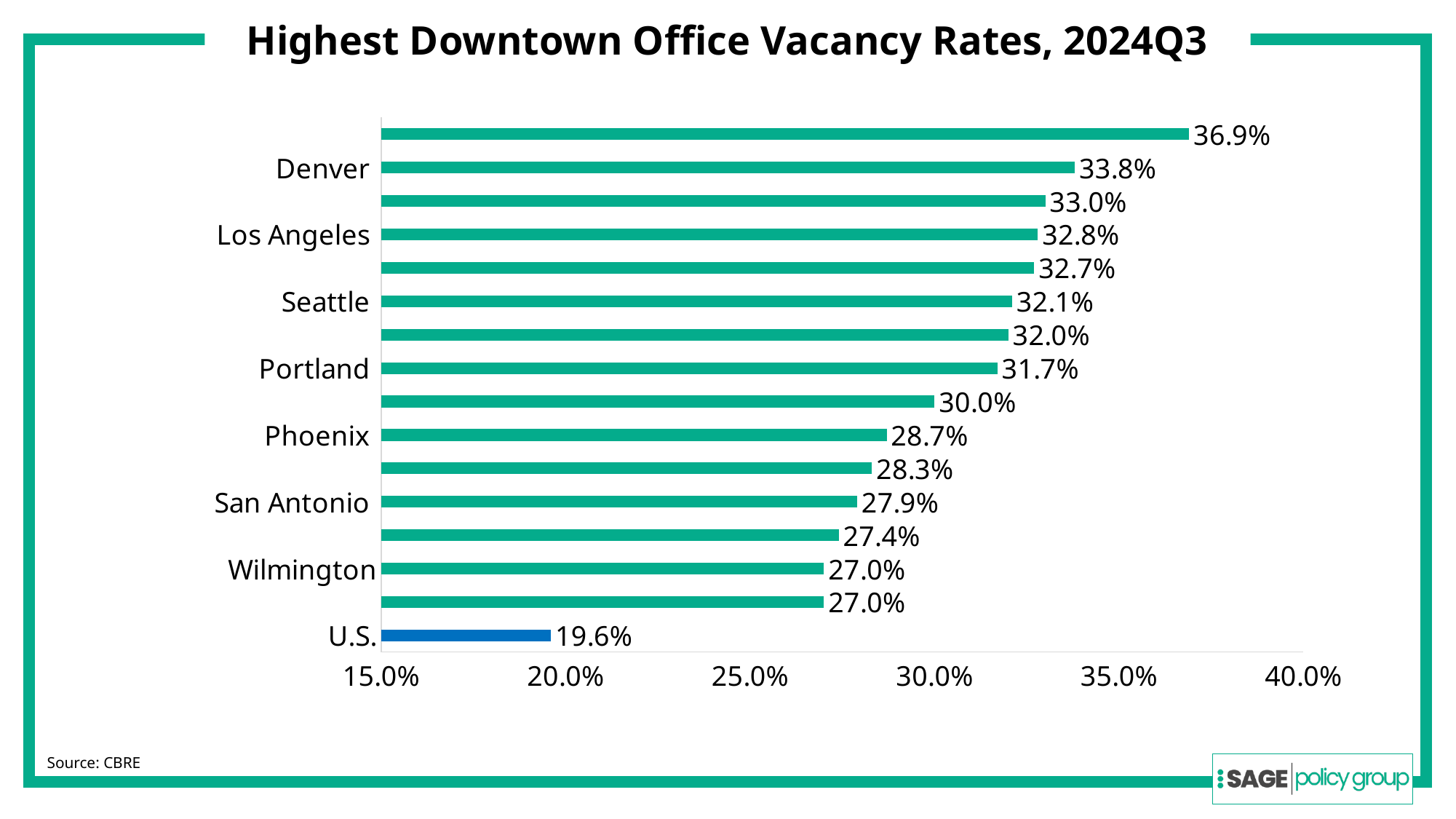
What type of chart is shown on the slide? Bar chart What is the downtown office vacancy rate for Los Angeles? 32.8% What is the downtown office vacancy rate for Seattle? 32.1% What is the difference between Denver's and Portland's vacancy rates? 2.1% How many bars are plotted on the chart? 16 What is the highest vacancy rate value shown on the chart? 36.9% Which bar is shown in a different colour (blue) from the others? U.S. Which has a higher vacancy rate, Phoenix or San Antonio? Phoenix What is the downtown office vacancy rate for Denver? 33.8% What is the downtown office vacancy rate for the U.S. overall? 19.6% Which has the lowest vacancy rate on the chart? U.S. What is the downtown office vacancy rate for Wilmington? 27.0%